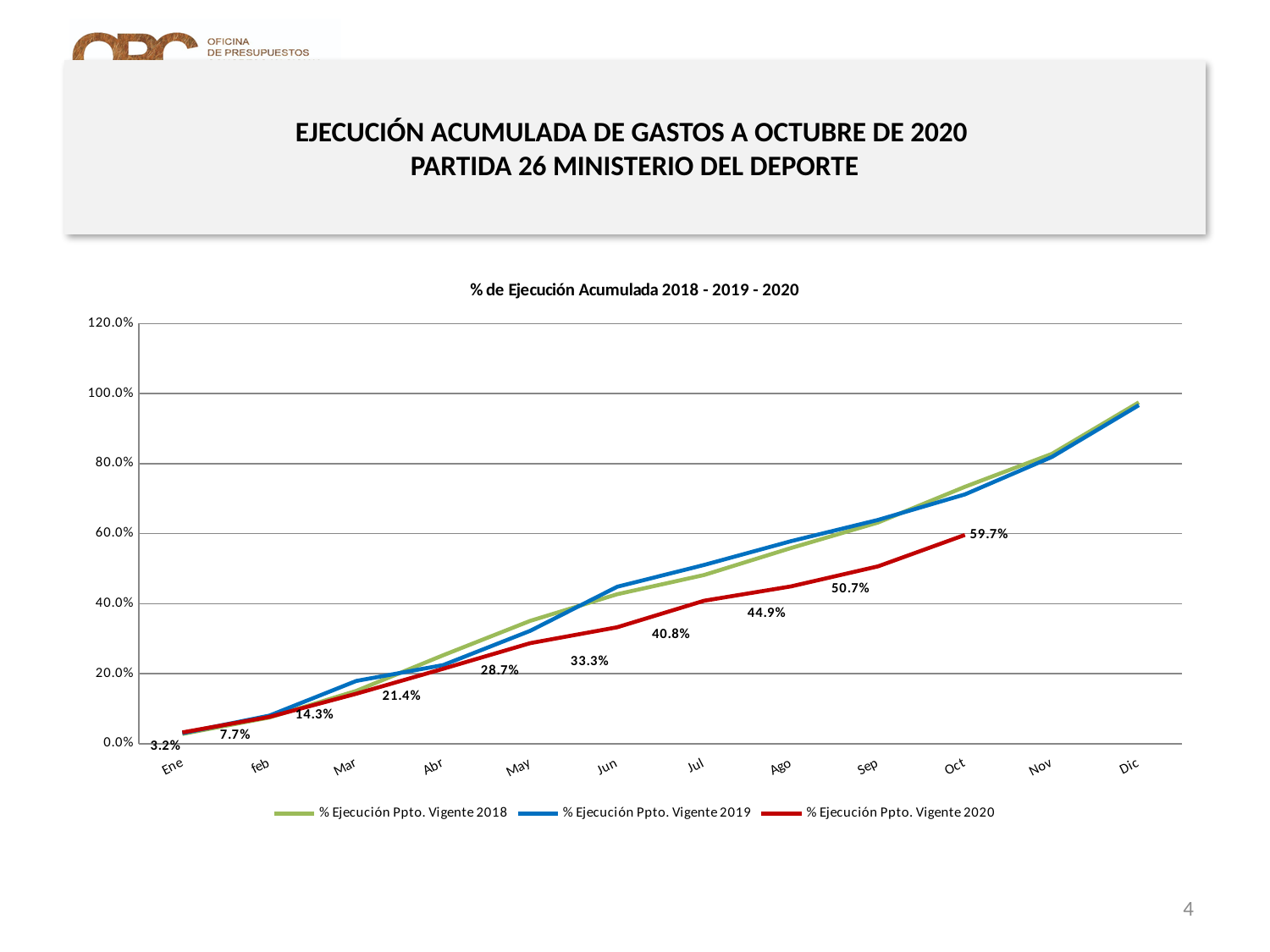
What kind of chart is shown on the slide? line chart What is the difference between the 2020 values for Jul and Jun? 7.5% What is the value of % Ejecución Ppto. Vigente 2020 in Ene? 3.2% What is the difference between the 2020 values for Oct and Sep? 9.0% Does the % Ejecución Ppto. Vigente 2020 line rise or fall from Ene to Oct? rise Is the value for % Ejecución Ppto. Vigente 2019 in Dic greater or less than 80.0%? greater Is the value for % Ejecución Ppto. Vigente 2018 in Jun greater or less than 60.0%? less What is the value of % Ejecución Ppto. Vigente 2020 in Jun? 33.3% How many series does the legend list? 3 In Jul, which series has the larger value: % Ejecución Ppto. Vigente 2019 or % Ejecución Ppto. Vigente 2020? % Ejecución Ppto. Vigente 2019 How many months are shown on the x axis? 12 What is the value of % Ejecución Ppto. Vigente 2020 in Oct? 59.7%